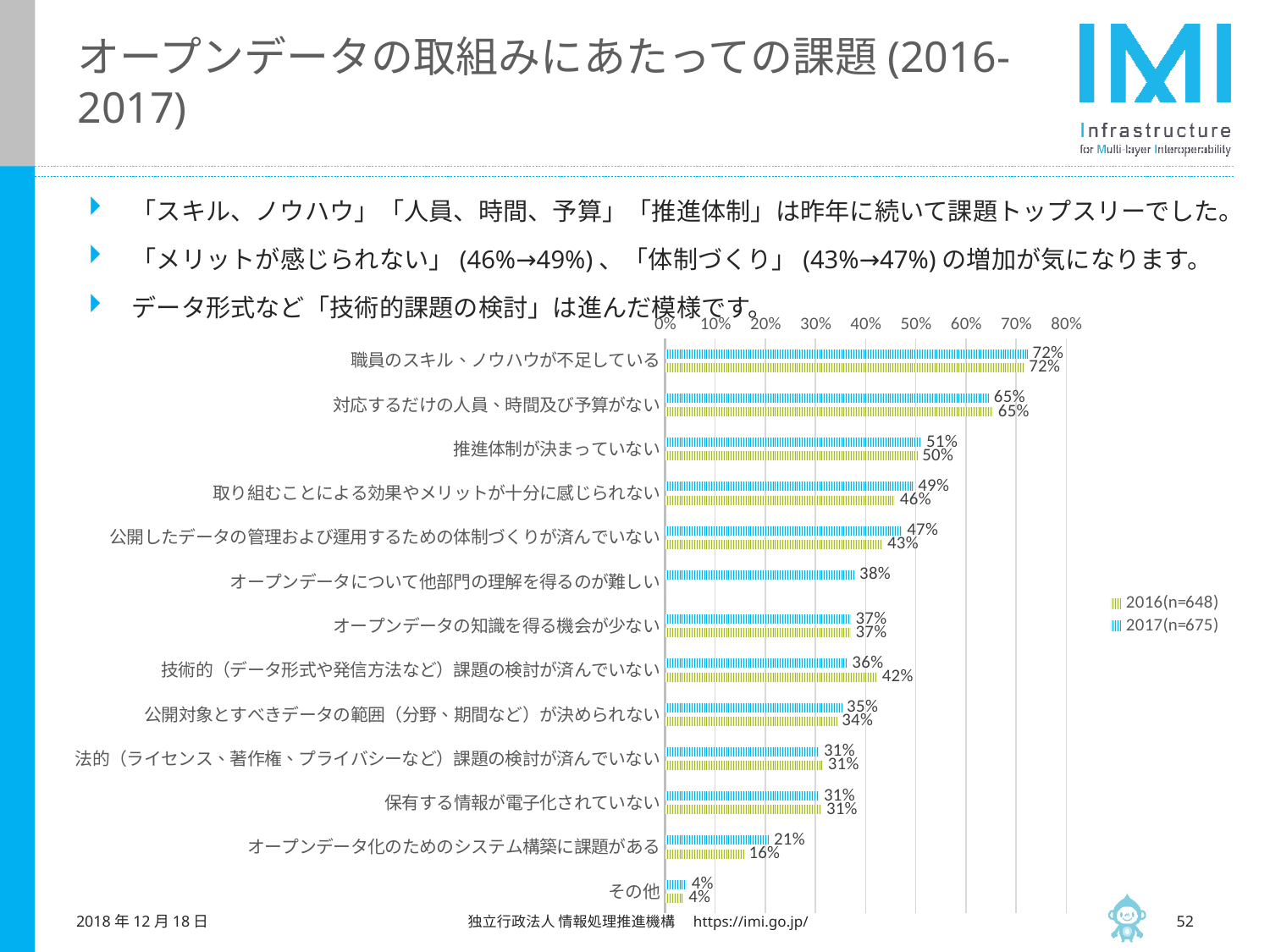
What is the 2017 value for 対応するだけの人員、時間及び予算がない? 65% What is the 2016 value for 技術的（データ形式や発信方法など）課題の検討が済んでいない? 42% Which category has the lowest value in the 2016 series? その他 What are the two legend entries of the chart? 2016(n=648) and 2017(n=675) For 技術的（データ形式や発信方法など）課題の検討が済んでいない, which year has the larger value, 2016 or 2017? 2016 How many categories are shown on the chart? 13 What is the 2016 value for 公開したデータの管理および運用するための体制づくりが済んでいない? 43% How many series does the legend list? 2 What is the difference between the 2017 and 2016 values for オープンデータ化のためのシステム構築に課題がある? 5% What kind of chart is shown on the slide? Bar chart Which category has the highest value in the 2017 series? 職員のスキル、ノウハウが不足している What is the 2017 value for 取り組むことによる効果やメリットが十分に感じられない? 49%